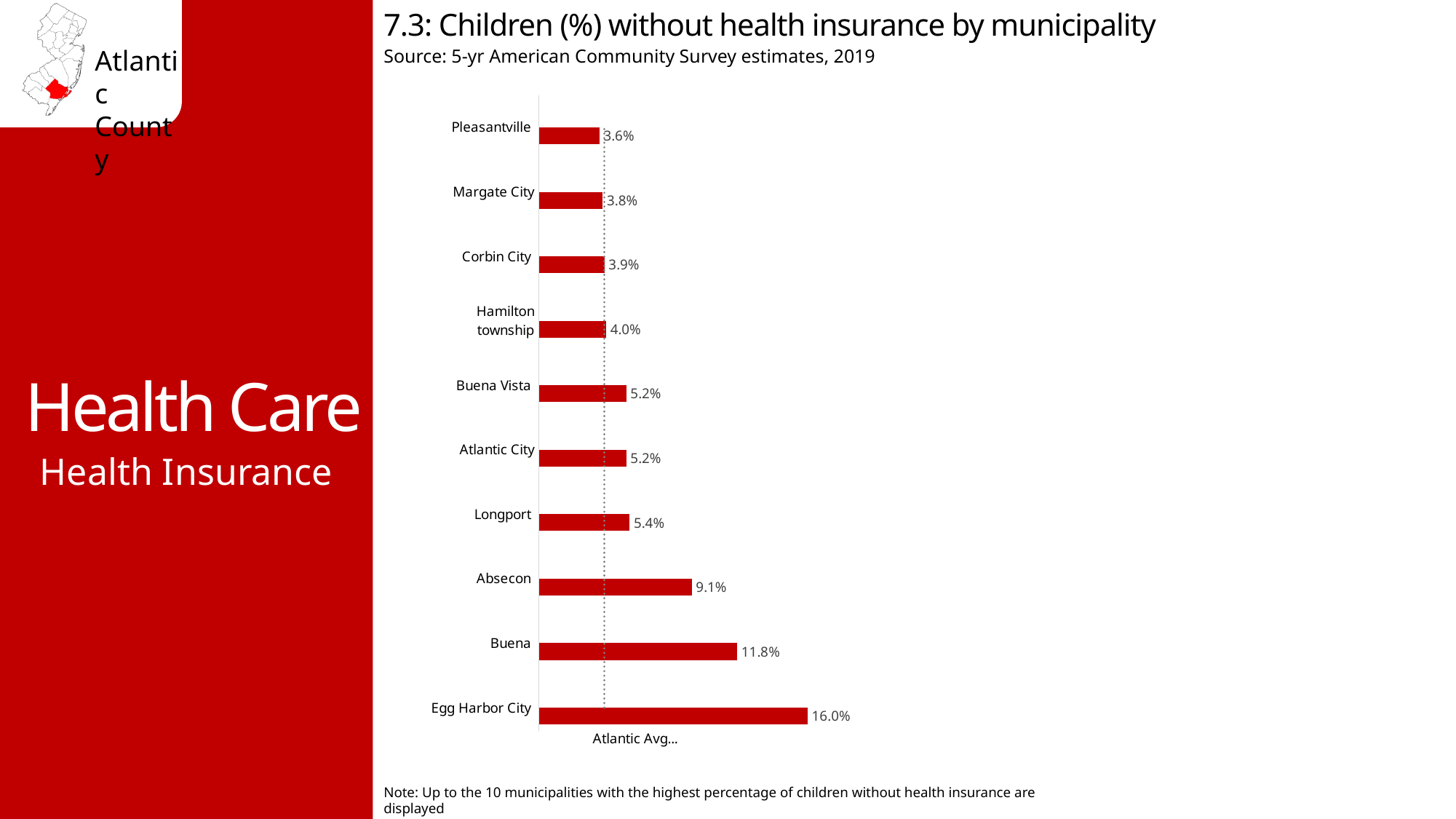
What is the source of the data shown in the chart? 5-yr American Community Survey estimates, 2019 Which municipality has the lowest percentage of children without health insurance? Pleasantville Which has a higher value, Longport or Margate City? Longport What is the value shown for Hamilton township? 4.0% Which has a higher value, Buena or Absecon? Buena What percentage of children in Egg Harbor City are without health insurance? 16.0% Which municipality has the highest percentage of children without health insurance? Egg Harbor City How many municipalities are shown in the chart? 10 What is the difference between the values for Egg Harbor City and Buena? 4.2% What is the difference between the values for Absecon and Longport? 3.7% What type of chart is shown on the slide? Bar chart What is the value shown for Absecon? 9.1%